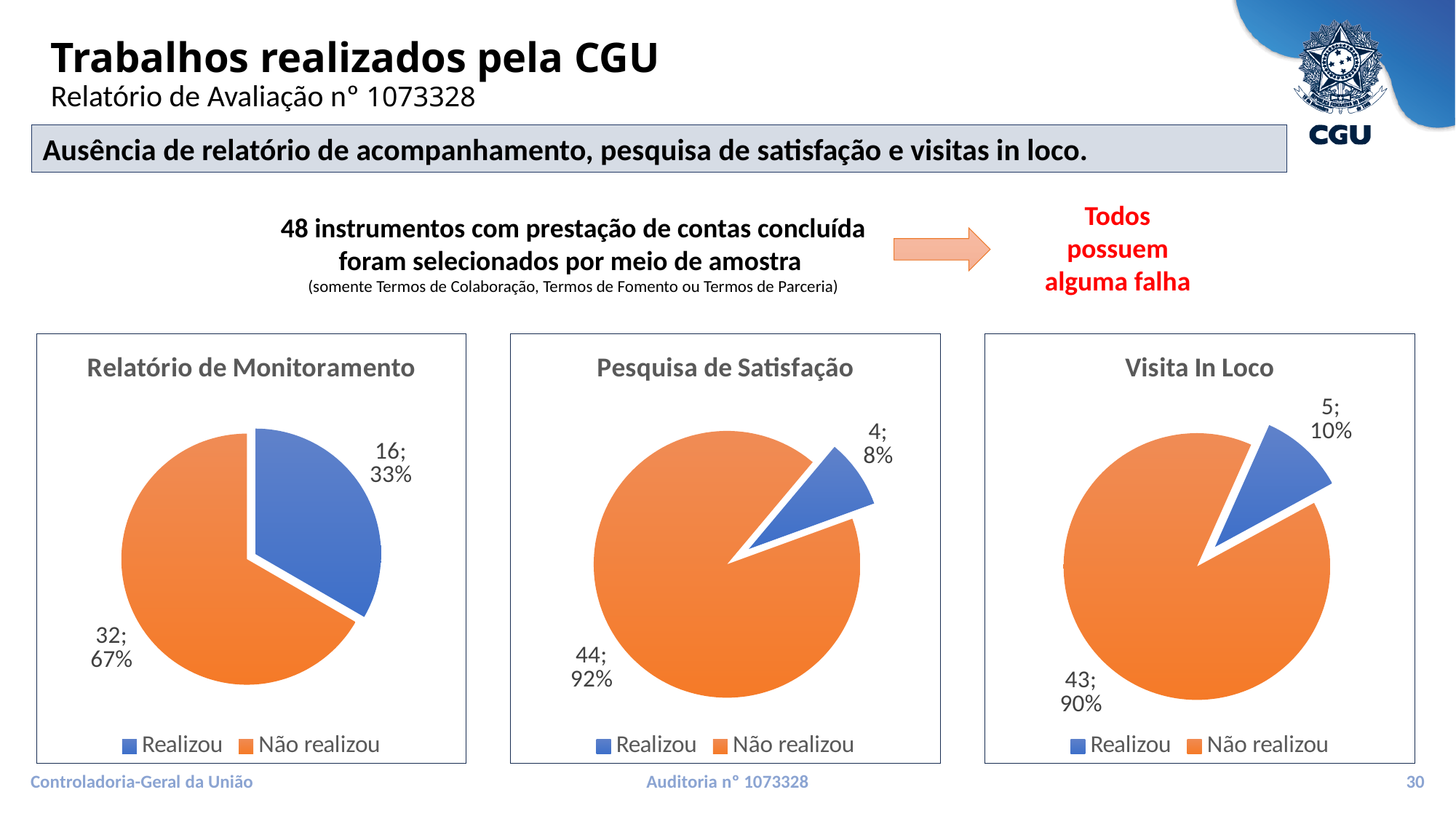
In the 'Relatório de Monitoramento' chart, what share of the pie is 'Não realizou'? 67% In the 'Pesquisa de Satisfação' chart, how many instruments are in the 'Não realizou' slice? 44 In the 'Visita In Loco' chart, what share of the pie is 'Não realizou'? 90% In the 'Visita In Loco' chart, what colour is the 'Realizou' slice? Blue What kind of chart is 'Relatório de Monitoramento'? Pie chart In the 'Pesquisa de Satisfação' chart, what is the difference between the 'Não realizou' and 'Realizou' counts? 40 In the 'Relatório de Monitoramento' chart, which slice is larger, 'Realizou' or 'Não realizou'? Não realizou In the 'Relatório de Monitoramento' chart, how many instruments are in the 'Realizou' slice? 16 In the 'Pesquisa de Satisfação' chart, what share of the pie is 'Realizou'? 8% How many slices does the 'Pesquisa de Satisfação' chart have? 2 In the 'Visita In Loco' chart, what is the total of the two slices? 48 In the 'Visita In Loco' chart, how many instruments are in the 'Realizou' slice? 5